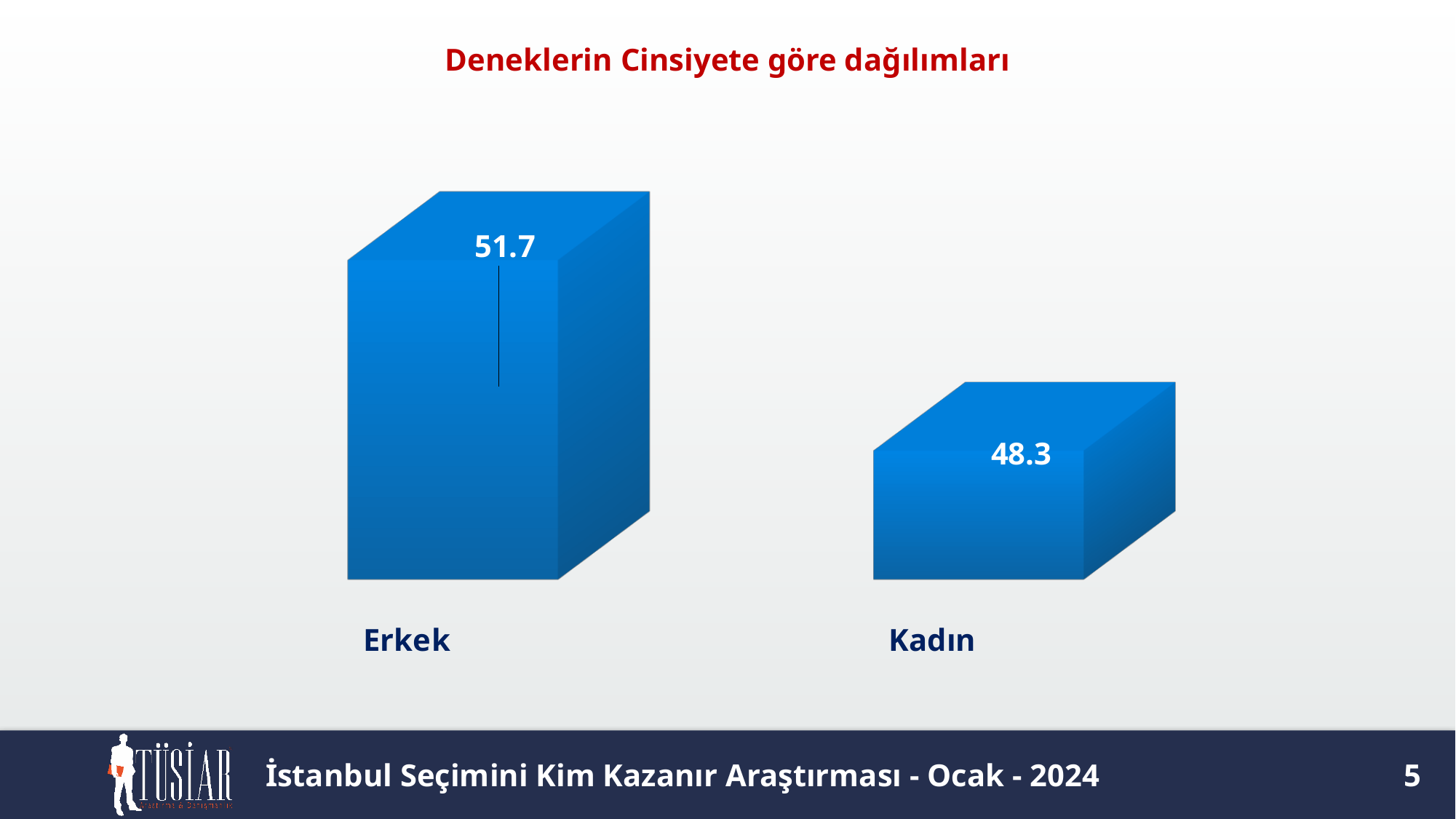
Which is larger, the value for Erkek or the value for Kadın? Erkek Which category has the highest value? Erkek How many categories are shown in the chart? 2 What is the value for Kadın? 48.3 Which category has the lowest value? Kadın What kind of chart is shown on the slide? bar chart What is the total of the two values shown in the chart? 100 What colour are the bars in the chart? blue What is the value for Erkek? 51.7 What is the difference between the values for Erkek and Kadın? 3.4 What is the title of the chart? Deneklerin Cinsiyete göre dağılımları